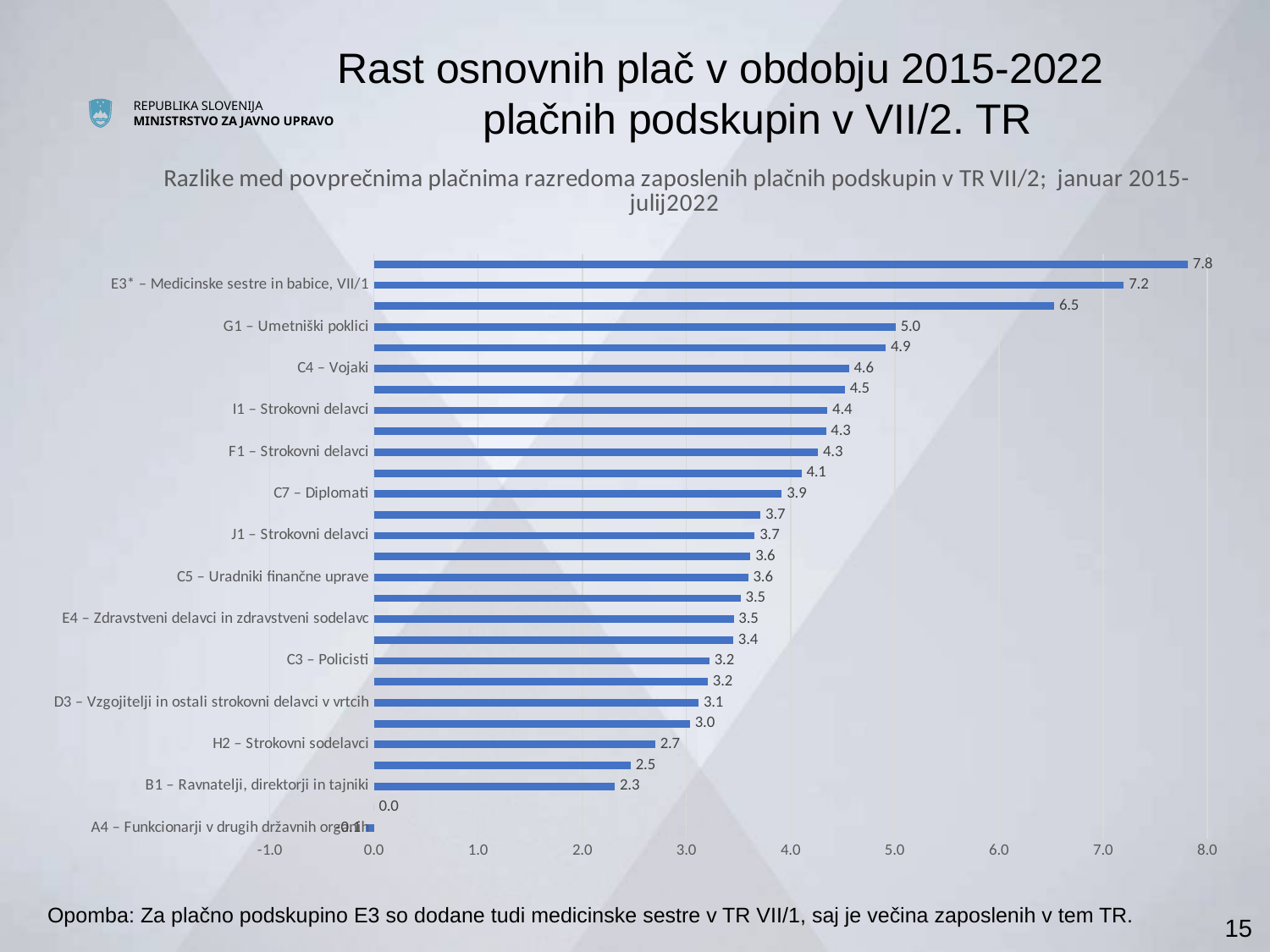
What is the value for G1 – Umetniški poklici? 5.0 What is the value for B1 – Ravnatelji, direktorji in tajniki? 2.3 What kind of chart is shown on the slide? bar chart Is the value for I1 – Strokovni delavci greater or less than 4.0? greater What is the difference between the values for E3* – Medicinske sestre in babice, VII/1 and B1 – Ravnatelji, direktorji in tajniki? 4.9 What is the value for C4 – Vojaki? 4.6 What is the largest value labelled on the chart? 7.8 What is the difference between the values for G1 – Umetniški poklici and C4 – Vojaki? 0.4 What is the value for E3* – Medicinske sestre in babice, VII/1? 7.2 What is the value for C7 – Diplomati? 3.9 Which has the larger value, C3 – Policisti or H2 – Strokovni sodelavci? C3 – Policisti What is the value for H2 – Strokovni sodelavci? 2.7